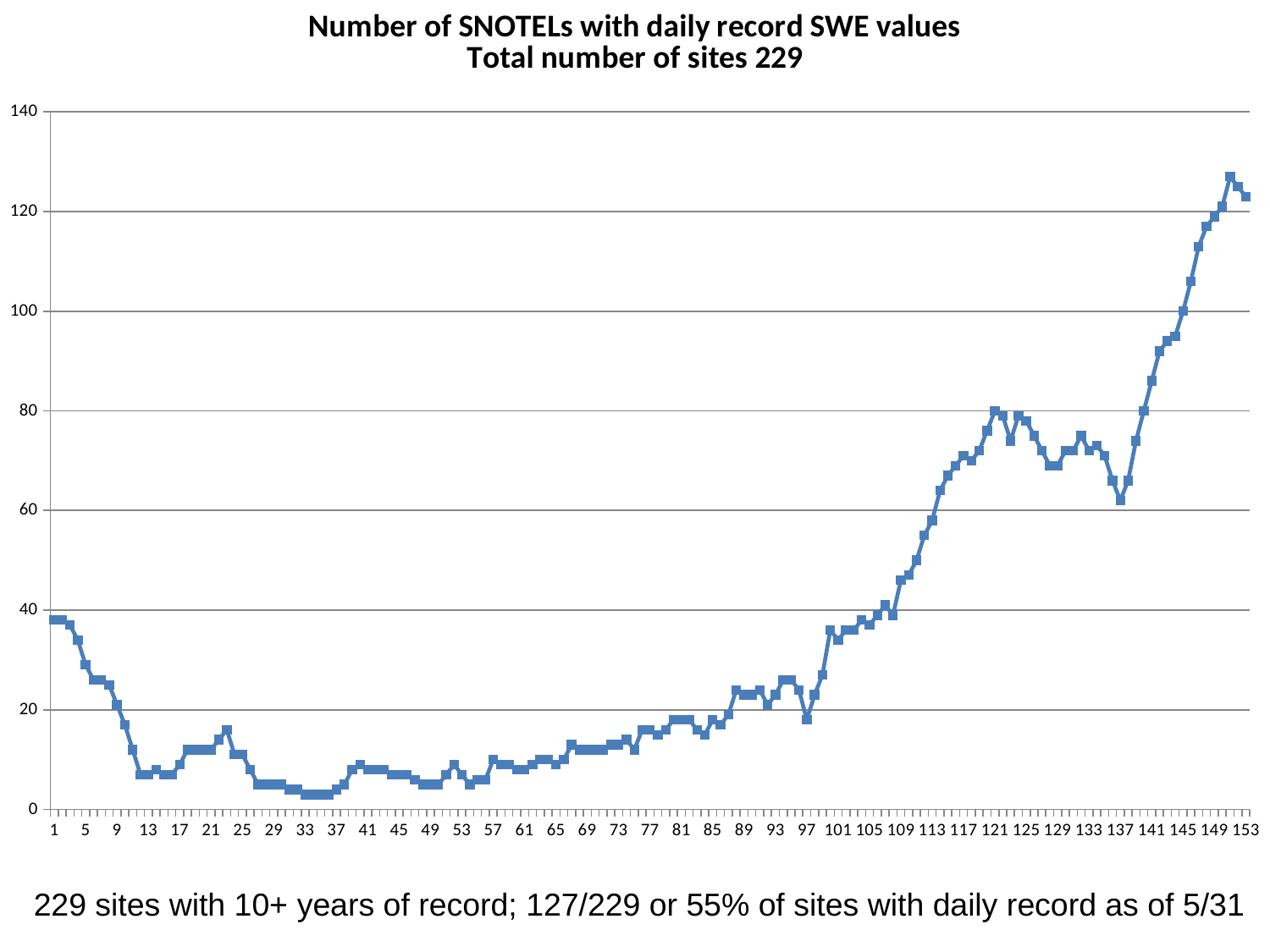
Is the value at x = 33 greater or less than 20? less Overall, do the values rise or fall from x = 1 to x = 153? rise Is the value at x = 153 greater or less than 100? greater What is the first line of the chart title? Number of SNOTELs with daily record SWE values Is the value at x = 137 greater or less than 80? less Which has the larger value, x = 1 or x = 153? x = 153 What is the highest value labelled on the y axis? 140 Which has the larger value, x = 9 or x = 13? x = 9 Which has the larger value, x = 121 or x = 137? x = 121 What kind of chart is shown on the slide? line chart